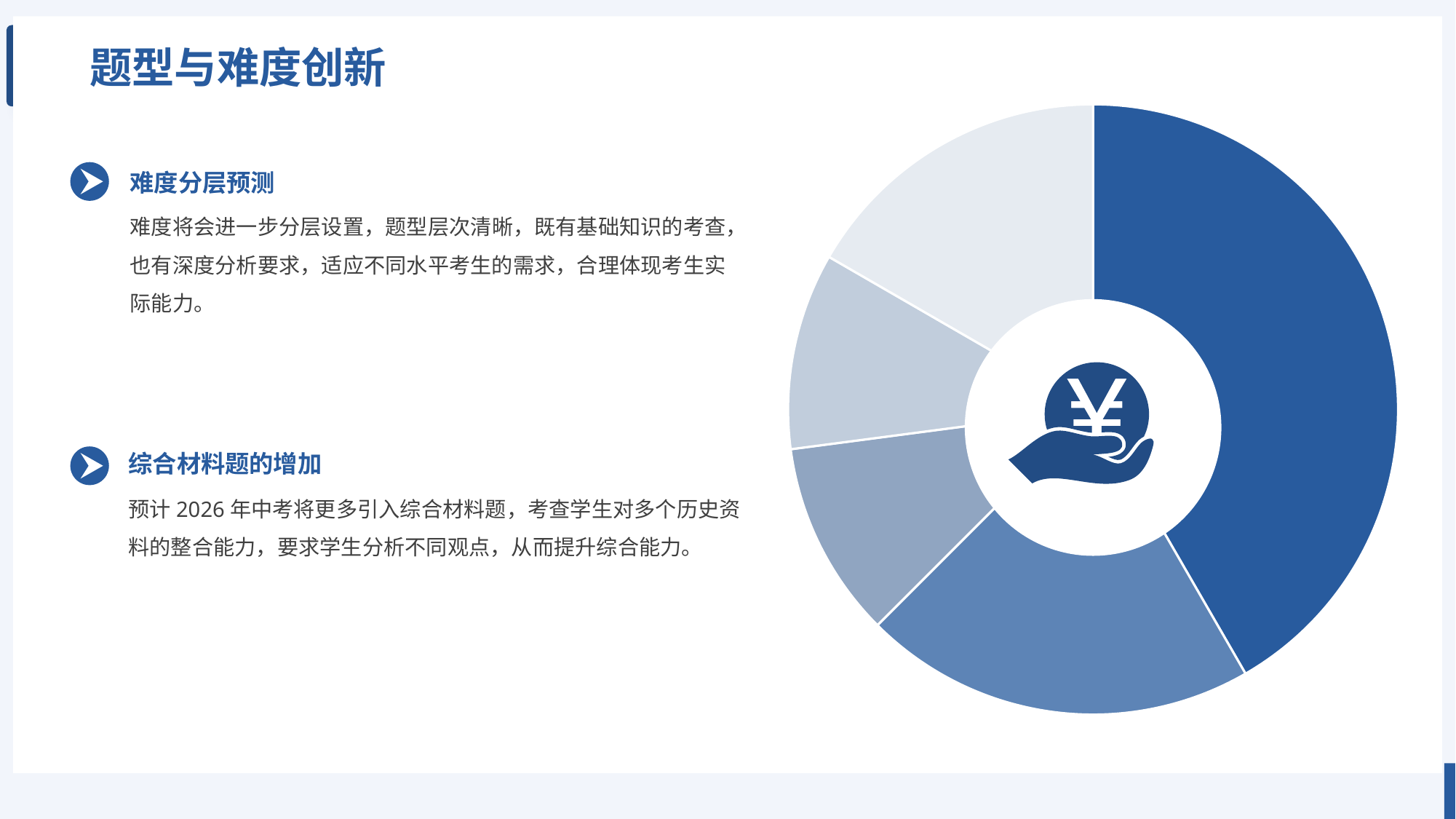
Does the doughnut chart display any data labels or a legend? No What kind of chart is shown on the right side of the slide? A doughnut (pie) chart Which slice of the doughnut chart is the largest? The dark blue slice on the right How many slices does the doughnut chart on the right contain? 5 What icon appears in the centre of the doughnut chart? A hand holding a yen/yuan (¥) coin